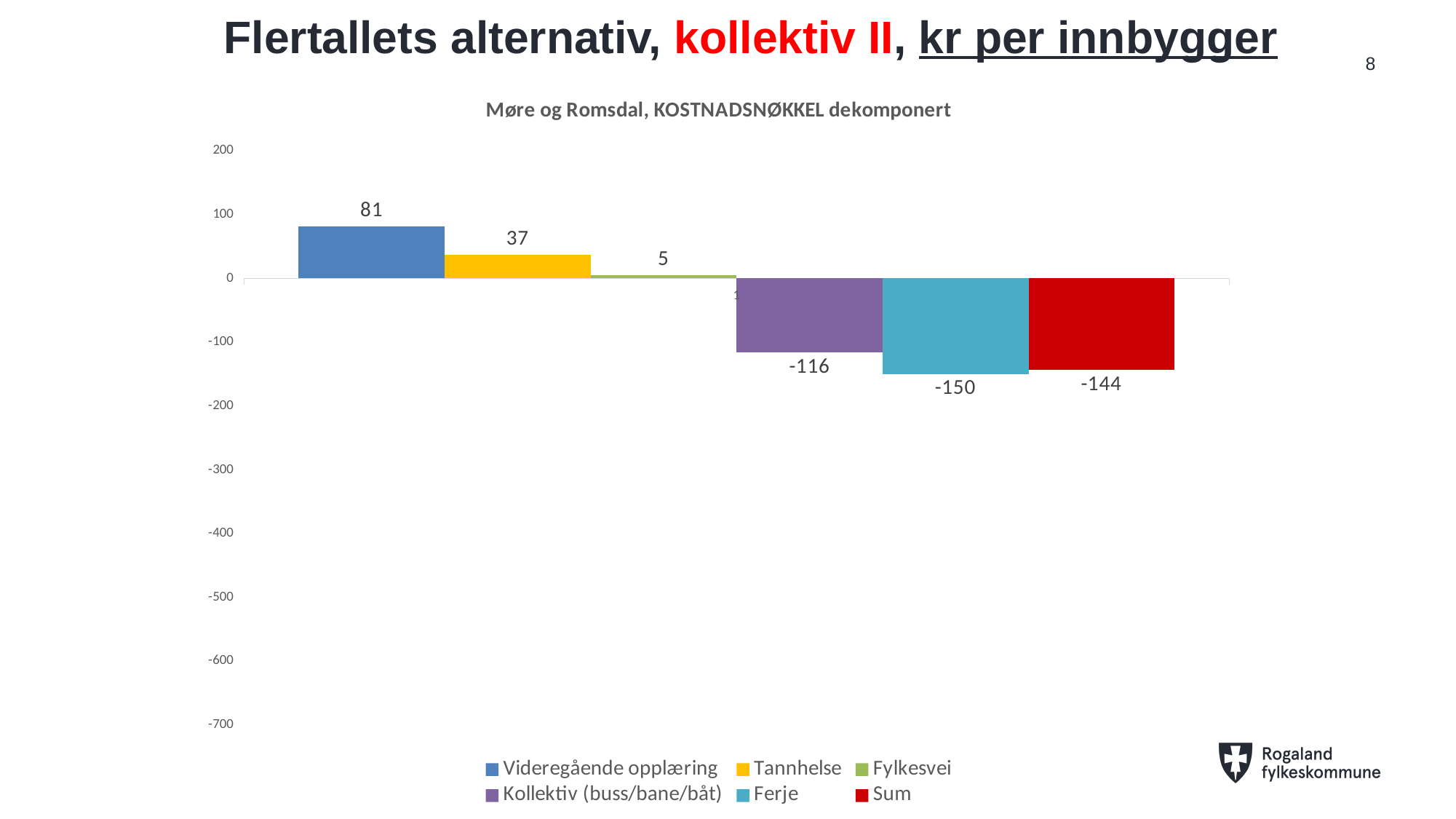
What is the value for Videregående opplæring? 81 Which series has the lowest value? Ferje How many series does the legend list? 6 What is the title of the chart? Møre og Romsdal, KOSTNADSNØKKEL dekomponert What kind of chart is shown on the slide? Bar chart Which is larger, the value for Kollektiv (buss/bane/båt) or the value for Ferje? Kollektiv (buss/bane/båt) Is the value for Fylkesvei greater or less than 100? less What is the value for Tannhelse? 37 What is the difference between the values for Videregående opplæring and Tannhelse? 44 What is the value for Ferje? -150 What is the value for Sum? -144 Which series has the highest value? Videregående opplæring